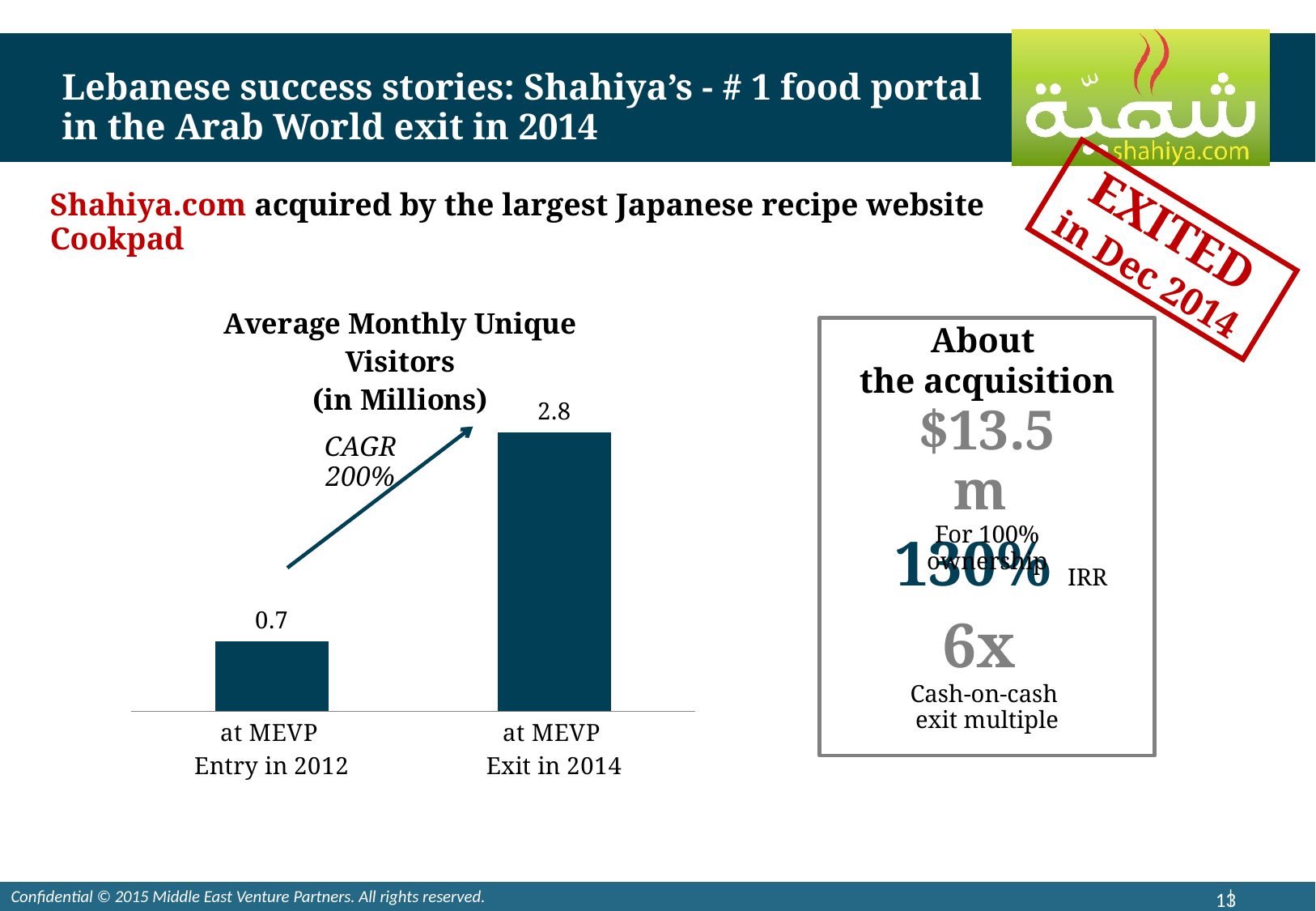
What is the difference between the values for 'at MEVP Exit in 2014' and 'at MEVP Entry in 2012' in the chart? 2.1 What CAGR is annotated on the chart? 200% How many categories are shown in the Average Monthly Unique Visitors chart? 2 Which category has the lowest value in the Average Monthly Unique Visitors chart? at MEVP Entry in 2012 Do the values in the Average Monthly Unique Visitors chart rise or fall from 2012 to 2014? Rise What kind of chart is used to show Average Monthly Unique Visitors? Bar chart What is the value for 'at MEVP Exit in 2014' in the Average Monthly Unique Visitors chart? 2.8 Which is larger in the chart: the value at MEVP Entry in 2012 or at MEVP Exit in 2014? at MEVP Exit in 2014 What is the value for 'at MEVP Entry in 2012' in the Average Monthly Unique Visitors chart? 0.7 What is the title of the chart on the slide? Average Monthly Unique Visitors (in Millions) Which category has the highest value in the Average Monthly Unique Visitors chart? at MEVP Exit in 2014